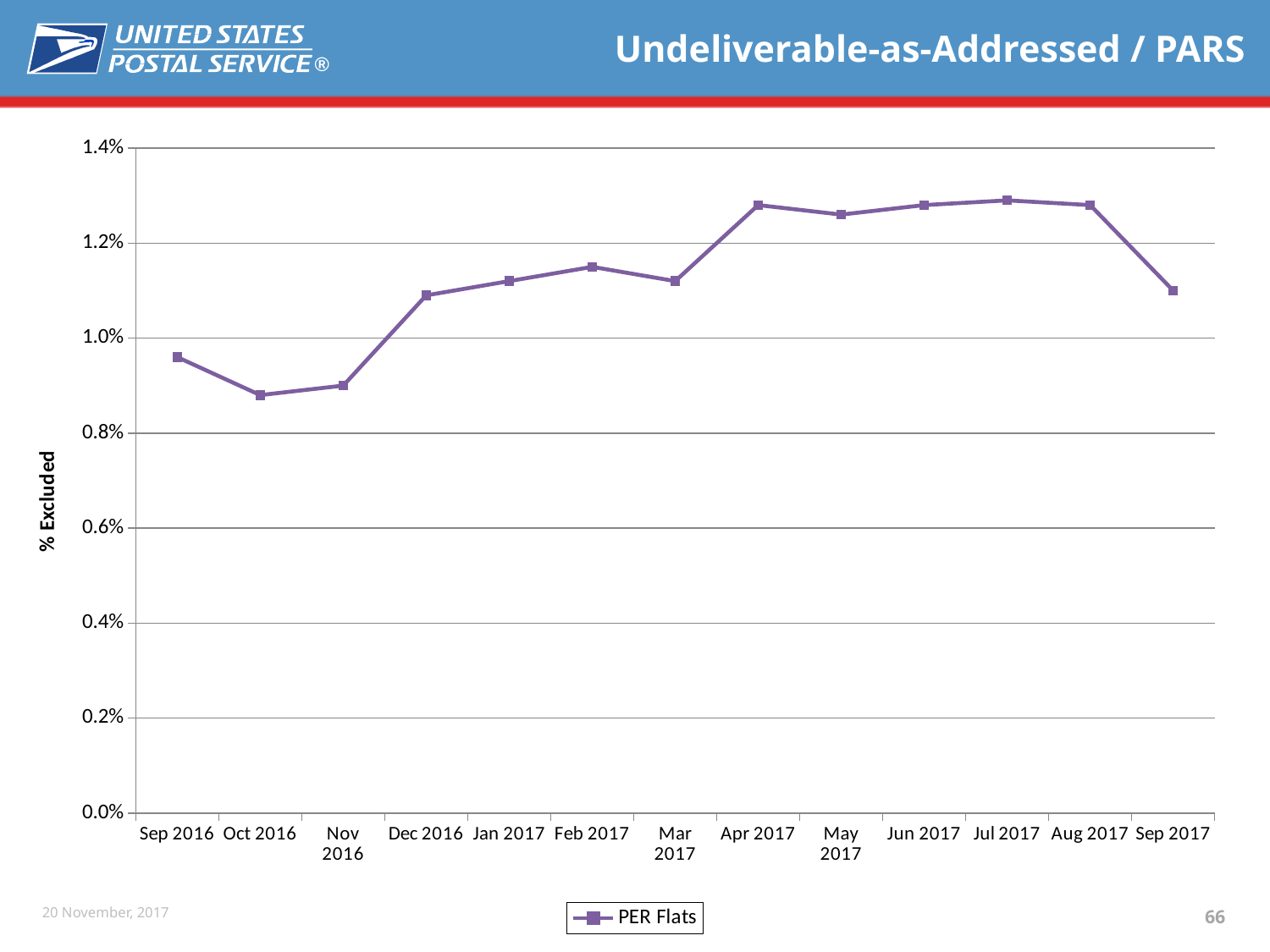
How many series does the legend list? 1 Does the value rise or fall from Mar 2017 to Apr 2017? rise How many monthly data points are plotted on the chart? 13 Is the value for Dec 2016 greater or less than 1.0%? greater Is the value for Apr 2017 greater or less than 1.2%? greater Which is larger, the value for Aug 2017 or the value for Sep 2017? Aug 2017 What is the name of the series shown in the legend? PER Flats What is the label on the vertical axis? % Excluded Is the value for Sep 2017 greater or less than 1.2%? less What kind of chart is shown on the slide? line chart Which is larger, the value for Sep 2016 or the value for Oct 2016? Sep 2016